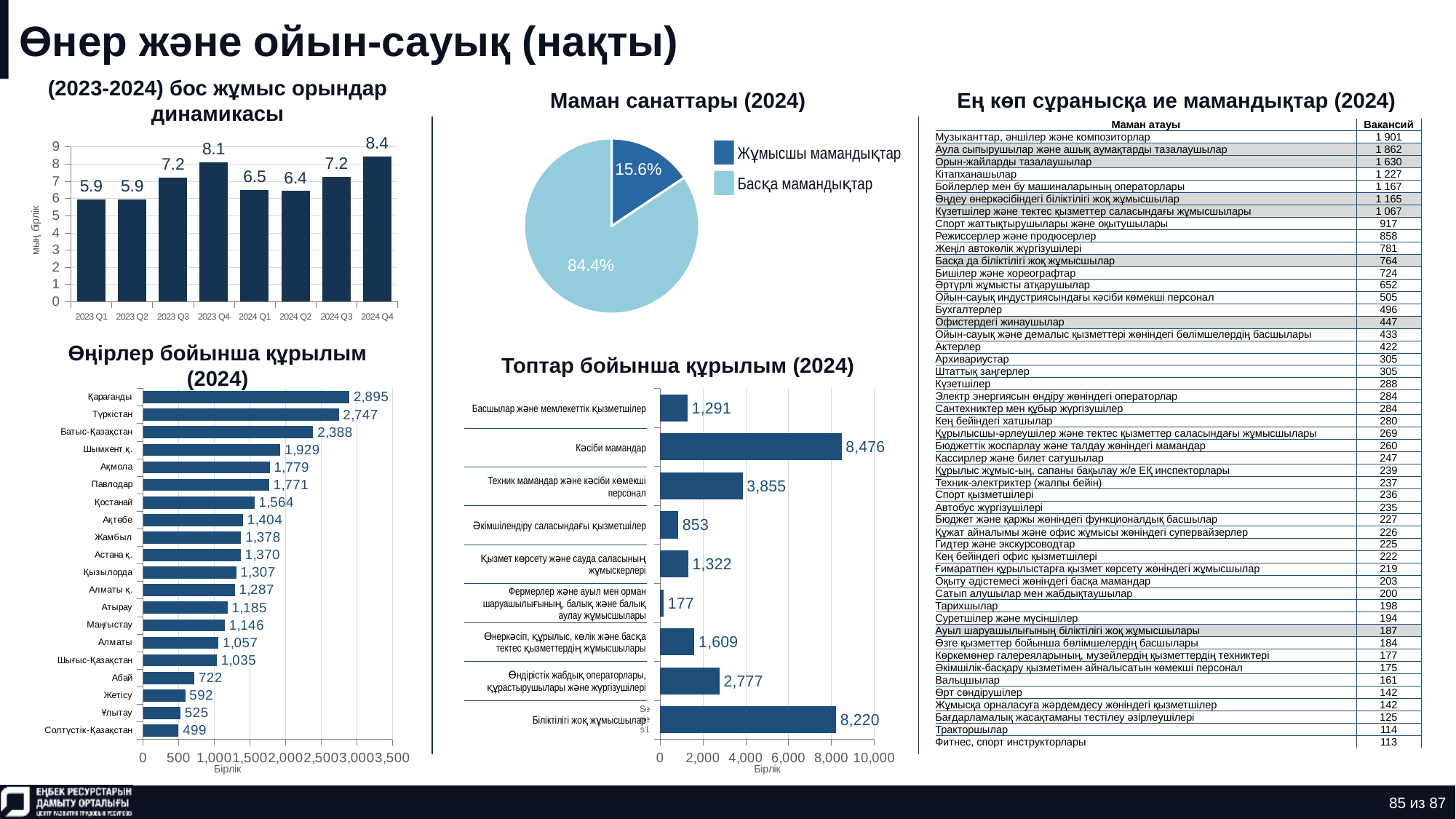
In the chart "Өңірлер бойынша құрылым (2024)", which region has the lowest value? Солтүстік-Қазақстан How many series does the legend of the pie chart "Маман санаттары (2024)" list? 2 In the chart "Өңірлер бойынша құрылым (2024)", which is larger: Қарағанды or Түркістан? Қарағанды In the chart "Топтар бойынша құрылым (2024)", what is the value for "Кәсіби мамандар"? 8,476 In the chart "Өңірлер бойынша құрылым (2024)", what is the value for Шымкент қ.? 1,929 In the chart "Топтар бойынша құрылым (2024)", what is the difference between "Кәсіби мамандар" and "Біліктілігі жоқ жұмысшылар"? 256 In the pie chart "Маман санаттары (2024)", what share does "Жұмысшы мамандықтар" have? 15.6% In the chart "(2023-2024) бос жұмыс орындар динамикасы", what is the difference between 2023 Q4 and 2024 Q1? 1.6 In the chart "(2023-2024) бос жұмыс орындар динамикасы", which quarter has the highest value? 2024 Q4 In the chart "(2023-2024) бос жұмыс орындар динамикасы", what is the value for 2024 Q4? 8.4 In the chart "(2023-2024) бос жұмыс орындар динамикасы", how many quarters are plotted? 8 What type of chart is "Топтар бойынша құрылым (2024)"? Bar chart